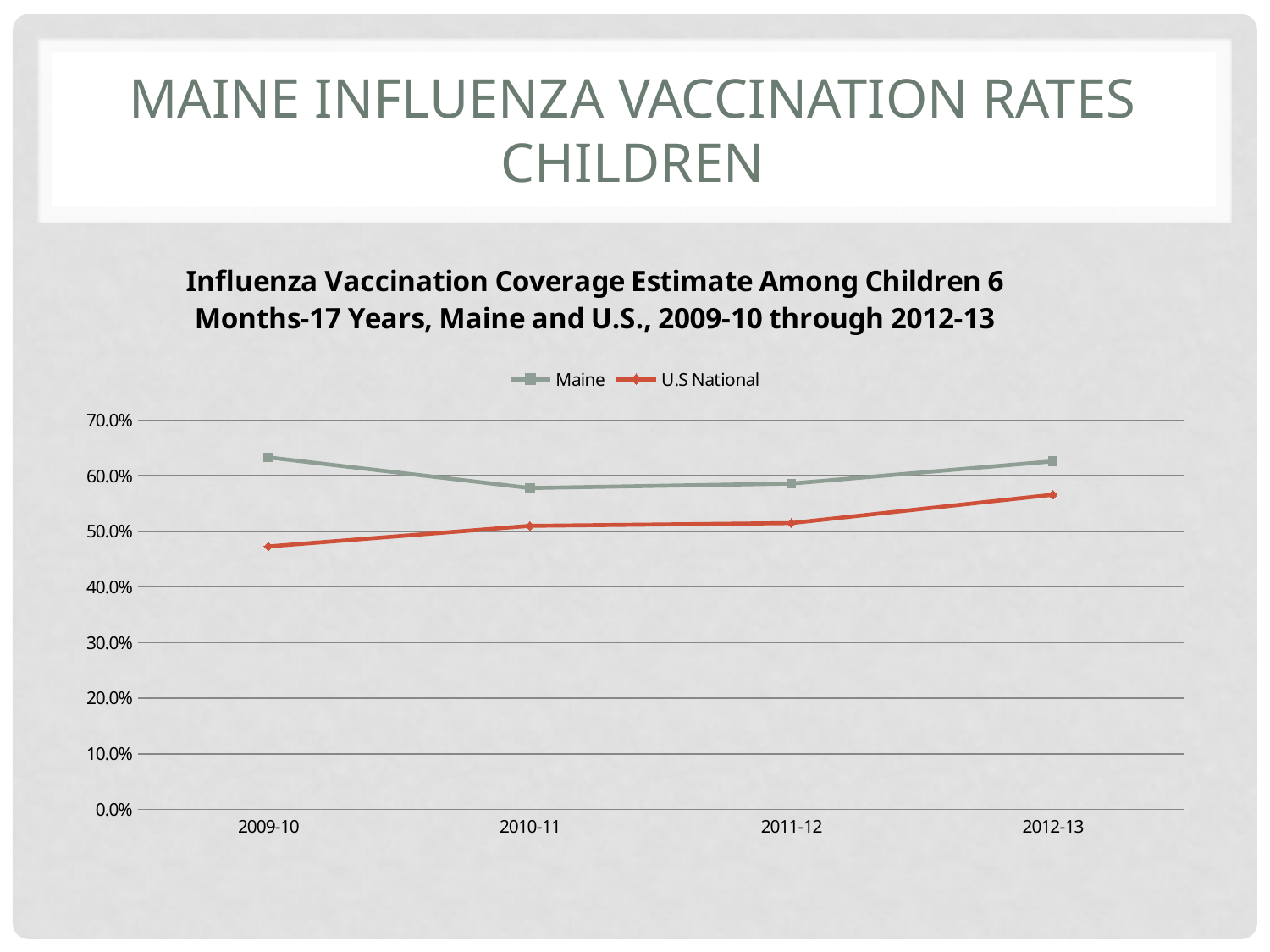
In which season is the U.S National value lowest? 2009-10 What kind of chart is shown on the slide? line chart Is the value for U.S National in 2009-10 greater or less than 50.0%? less How many series does the legend list? 2 Is the value for U.S National in 2012-13 greater or less than 60.0%? less How many seasons are plotted along the x axis? 4 Is the value for Maine in 2009-10 greater or less than 60.0%? greater In which season is the U.S National value highest? 2012-13 Does the U.S National line rise or fall from 2009-10 to 2012-13? rise In 2009-10, which is larger, the Maine value or the U.S National value? Maine Which series is shown in red? U.S National